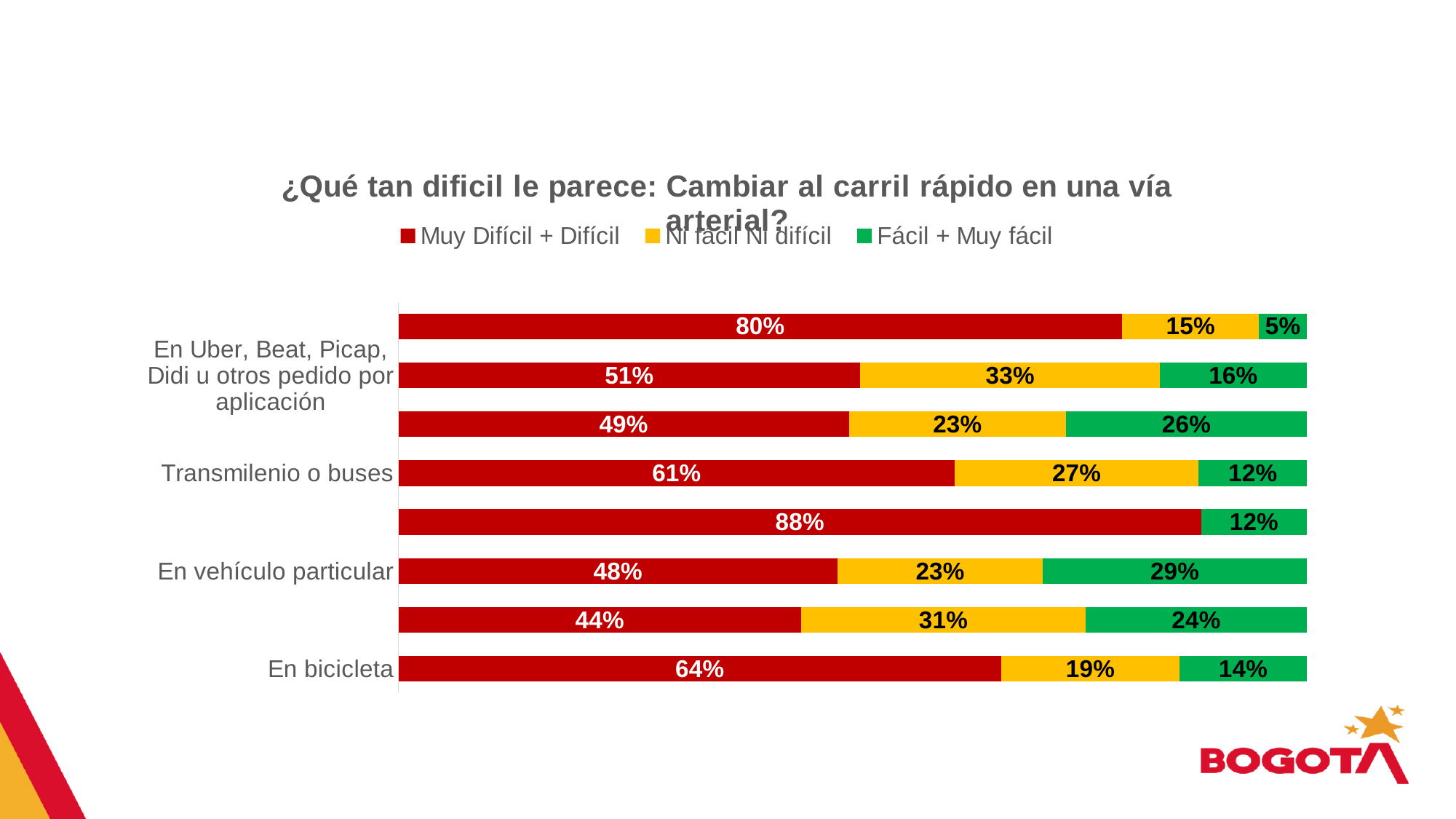
What is the Ni fácil Ni difícil value for En vehículo particular? 23% What is the Muy Difícil + Difícil value for Transmilenio o buses? 61% What is the difference between the Muy Difícil + Difícil values for En bicicleta and Transmilenio o buses? 3 percentage points How many series does the legend list? 3 What is the Fácil + Muy fácil value for En bicicleta? 14% What kind of chart is shown on the slide? Stacked bar chart How many bars are plotted in the chart? 8 What colour represents the Fácil + Muy fácil series in the legend? Green What is the Muy Difícil + Difícil value for the top bar of the chart? 80% What is the lowest Fácil + Muy fácil value shown in the chart? 5% What is the highest Muy Difícil + Difícil value shown in the chart? 88% Which has the larger Fácil + Muy fácil value, En vehículo particular or En bicicleta? En vehículo particular